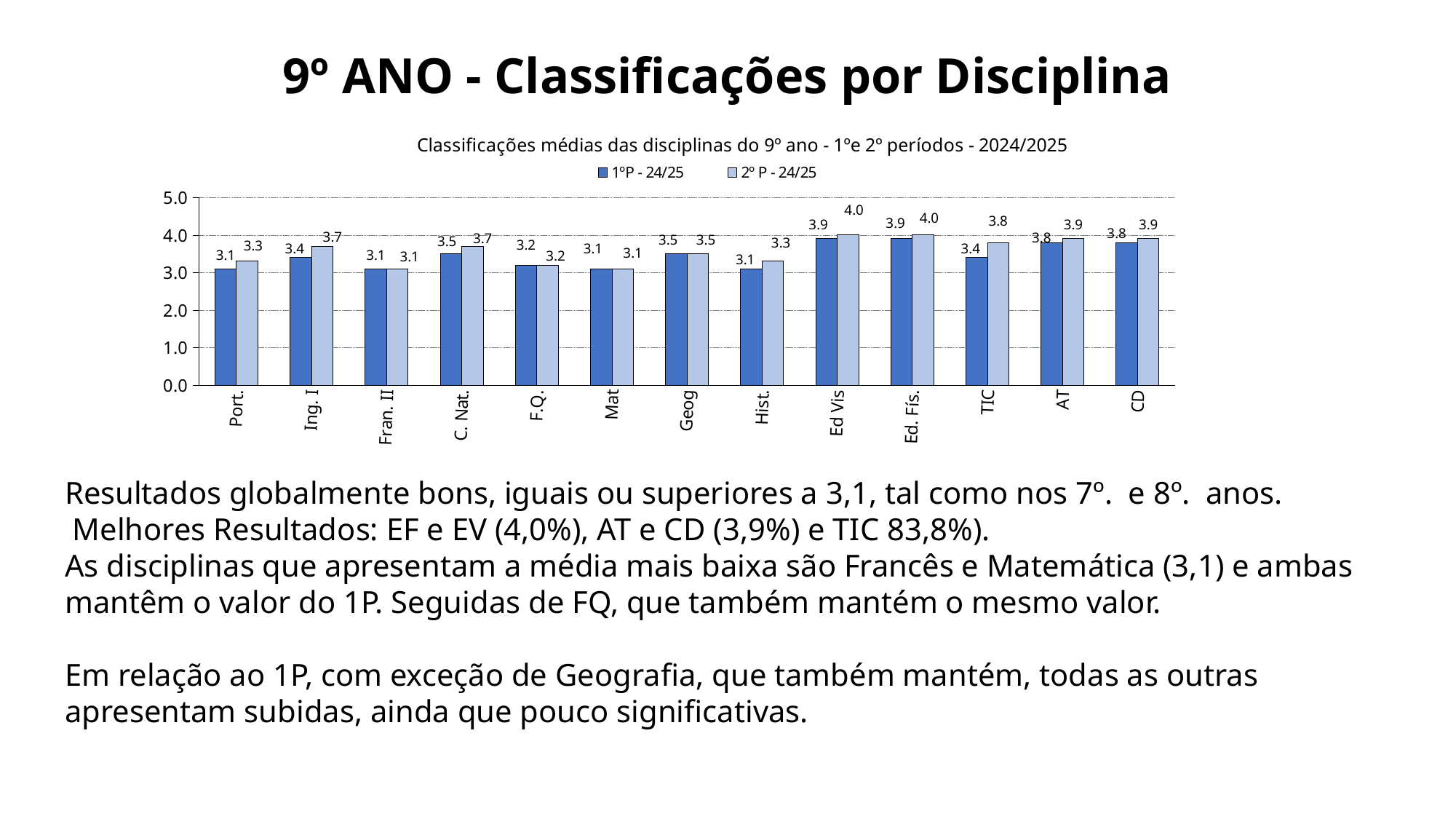
What is the value for TIC in the 2º P - 24/25 series? 3.8 Which is larger for Port.: the 1ºP - 24/25 value or the 2º P - 24/25 value? 2º P - 24/25 What is the value for Ed Vis in the 1ºP - 24/25 series? 3.9 What is the title of the chart? Classificações médias das disciplinas do 9º ano - 1ºe 2º períodos - 2024/2025 What is the value for Hist. in the 2º P - 24/25 series? 3.3 What is the value for Ing. I in the 1ºP - 24/25 series? 3.4 What is the difference between the 2º P - 24/25 and 1ºP - 24/25 values for TIC? 0.4 How many disciplines (categories) are shown on the x axis? 13 What kind of chart is shown on the slide? Bar chart Which is larger in the 2º P - 24/25 series: C. Nat. or Geog? C. Nat. How many series does the legend list? 2 What is the difference between the 2º P - 24/25 and 1ºP - 24/25 values for Ing. I? 0.3